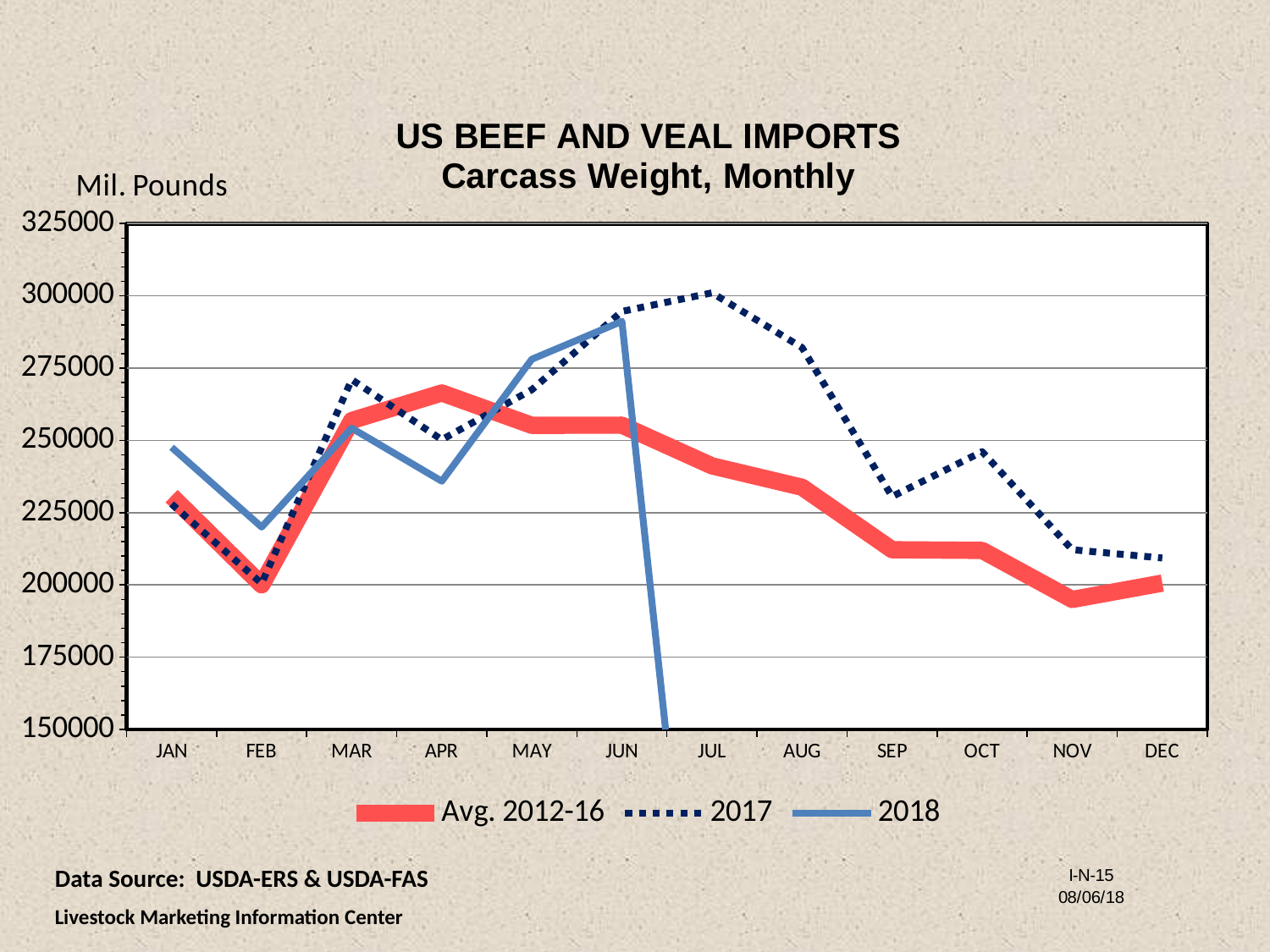
Is the 2017 value for FEB greater or less than 225000? less In which month does the 2017 series reach its highest value? JUL In which month does the 2017 series reach its lowest value? FEB Does the 2017 series rise or fall from JUL to DEC? Fall What kind of chart is shown on the slide? Line chart Is the 2018 value for JUN greater or less than 275000? greater In which month does the Avg. 2012-16 series reach its highest value? APR In JUL, which series has the larger value, 2017 or Avg. 2012-16? 2017 How many months are shown along the x axis? 12 Is the 2017 value for JUL greater or less than 275000? greater How many series does the legend list? 3 In JAN, which series has the larger value, 2018 or Avg. 2012-16? 2018